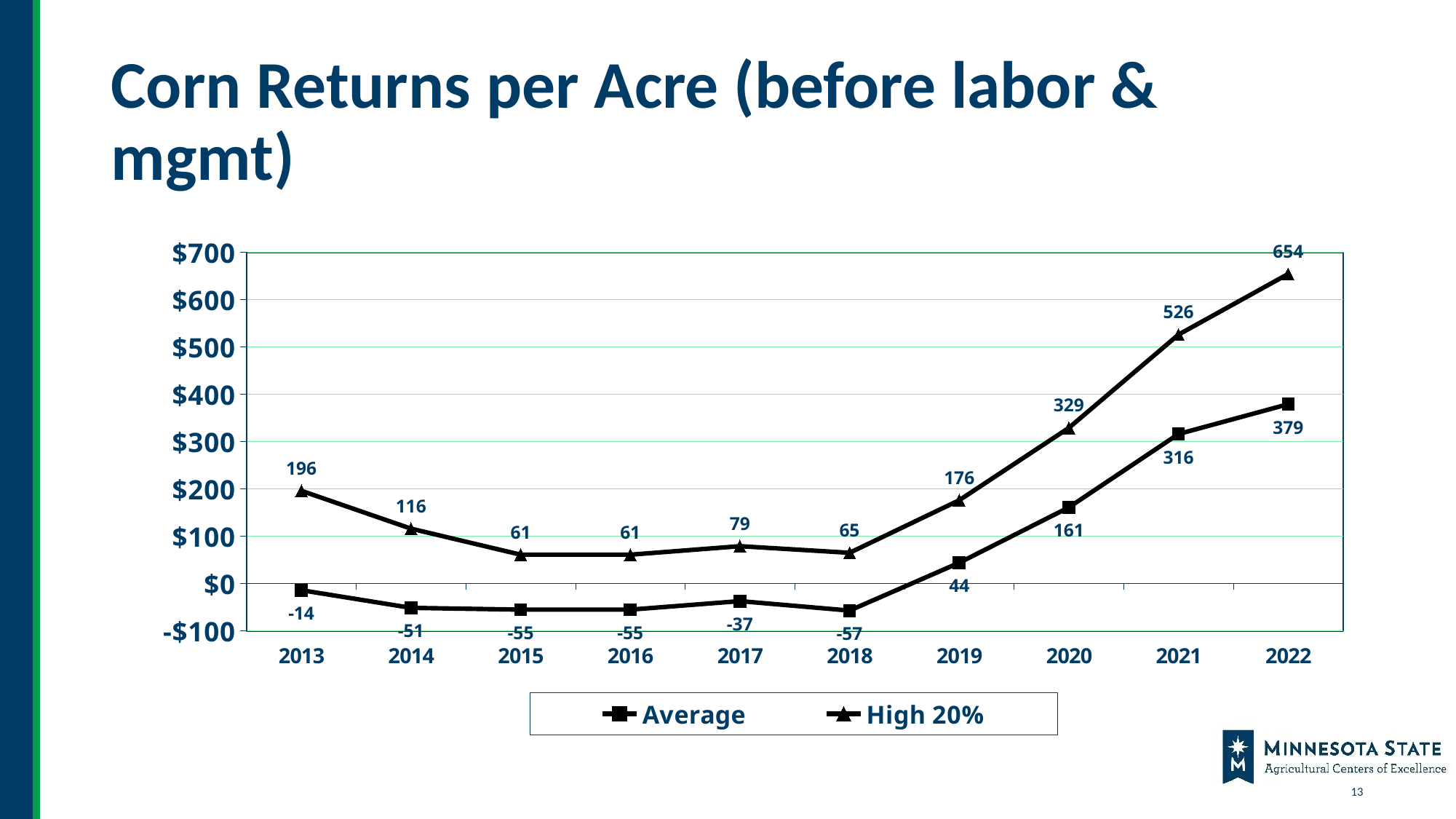
How many years are shown on the x axis? 10 What is the Average corn return per acre in 2022? 379 In which year is the Average return per acre lowest? 2018 How many series does the legend list? 2 What is the High 20% corn return per acre in 2013? 196 What is the Average corn return per acre in 2018? -57 What is the difference between the High 20% and Average returns in 2021? 210 In which year is the High 20% return per acre highest? 2022 What marker shape is used for the High 20% series in the legend? Triangle What kind of chart is shown on the slide? Line chart Which is larger: the High 20% return in 2020 or the Average return in 2021? High 20% return in 2020 Do the Average returns rise or fall from 2018 to 2022? Rise